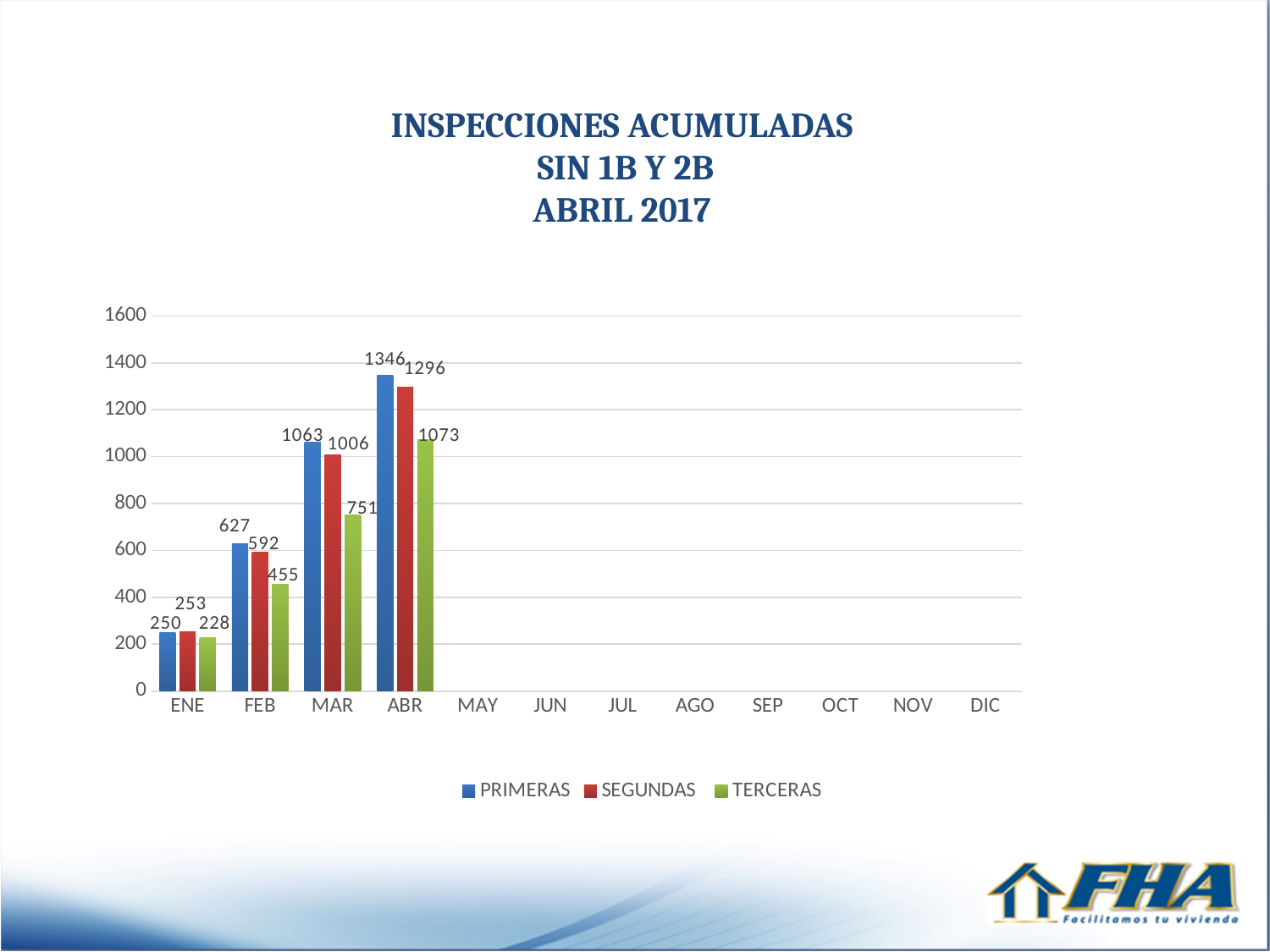
How many month categories are shown on the x axis? 12 What is the value for SEGUNDAS in ABR? 1296 What is the value for TERCERAS in FEB? 455 What is the difference between SEGUNDAS and TERCERAS in MAR? 255 Which month has the highest value for PRIMERAS? ABR Which is larger in ENE, PRIMERAS or SEGUNDAS? SEGUNDAS Which month has the lowest value for TERCERAS? ENE What is the difference between PRIMERAS and SEGUNDAS in ABR? 50 How many series does the legend list? 3 What kind of chart is shown on the slide? bar chart What is the value for PRIMERAS in MAR? 1063 Do the values for TERCERAS rise or fall from ENE to ABR? rise